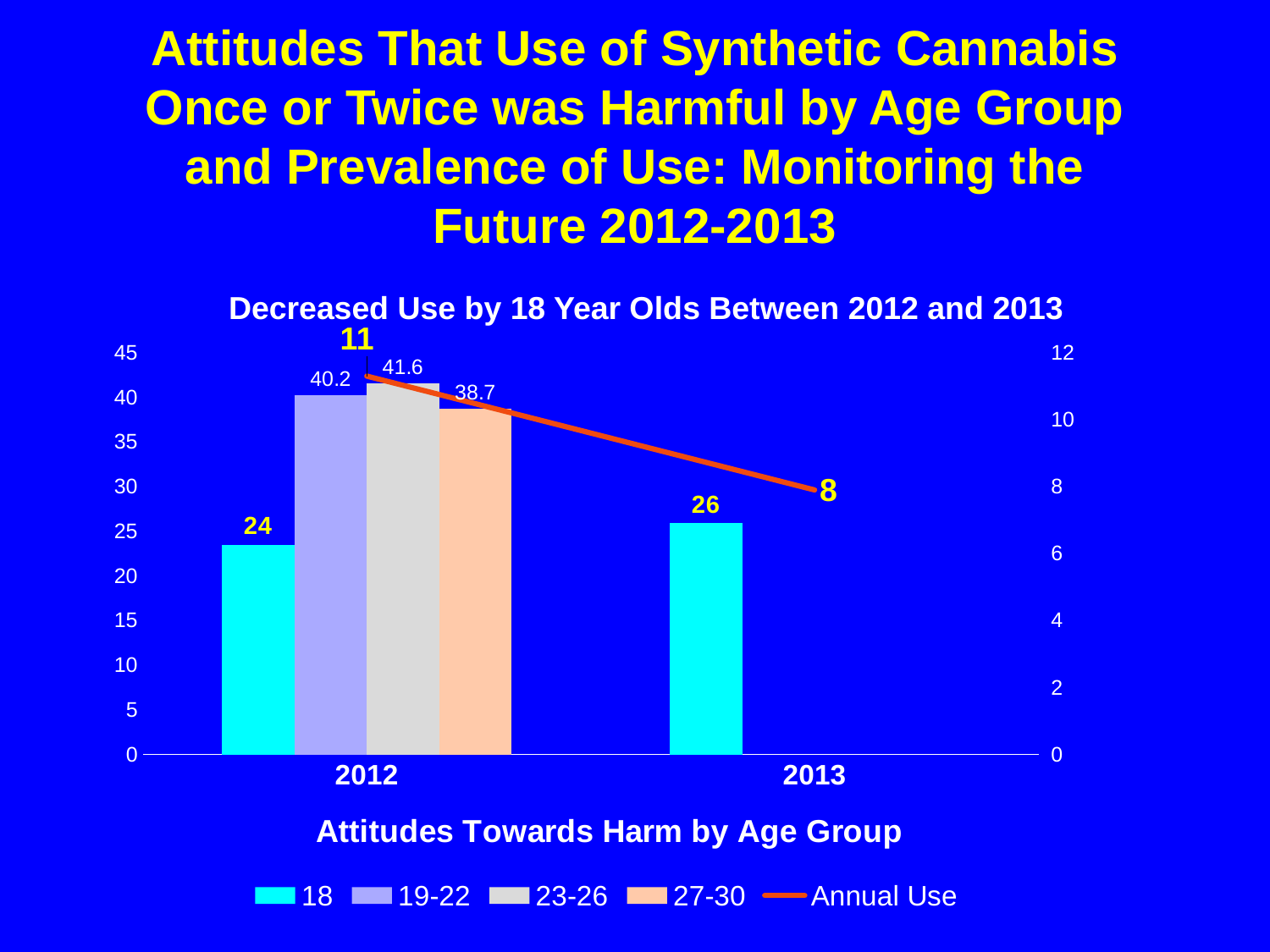
How many entries does the legend list? 5 Which is larger in 2012: the value for 19-22 or the value for 27-30? 19-22 Which age group has the lowest value in 2012? 18 What is the title of the chart? Decreased Use by 18 Year Olds Between 2012 and 2013 What is the label on the horizontal axis of the chart? Attitudes Towards Harm by Age Group What is the value for the 18 age group in 2012? 24 What is the value for the 18 age group in 2013? 26 What is the difference between the 23-26 and 27-30 values in 2012? 2.9 Which age group has the highest value in 2012? 23-26 Does the Annual Use line rise or fall from 2012 to 2013? fall What is the value for the 23-26 age group in 2012? 41.6 What is the Annual Use value for 2013? 8